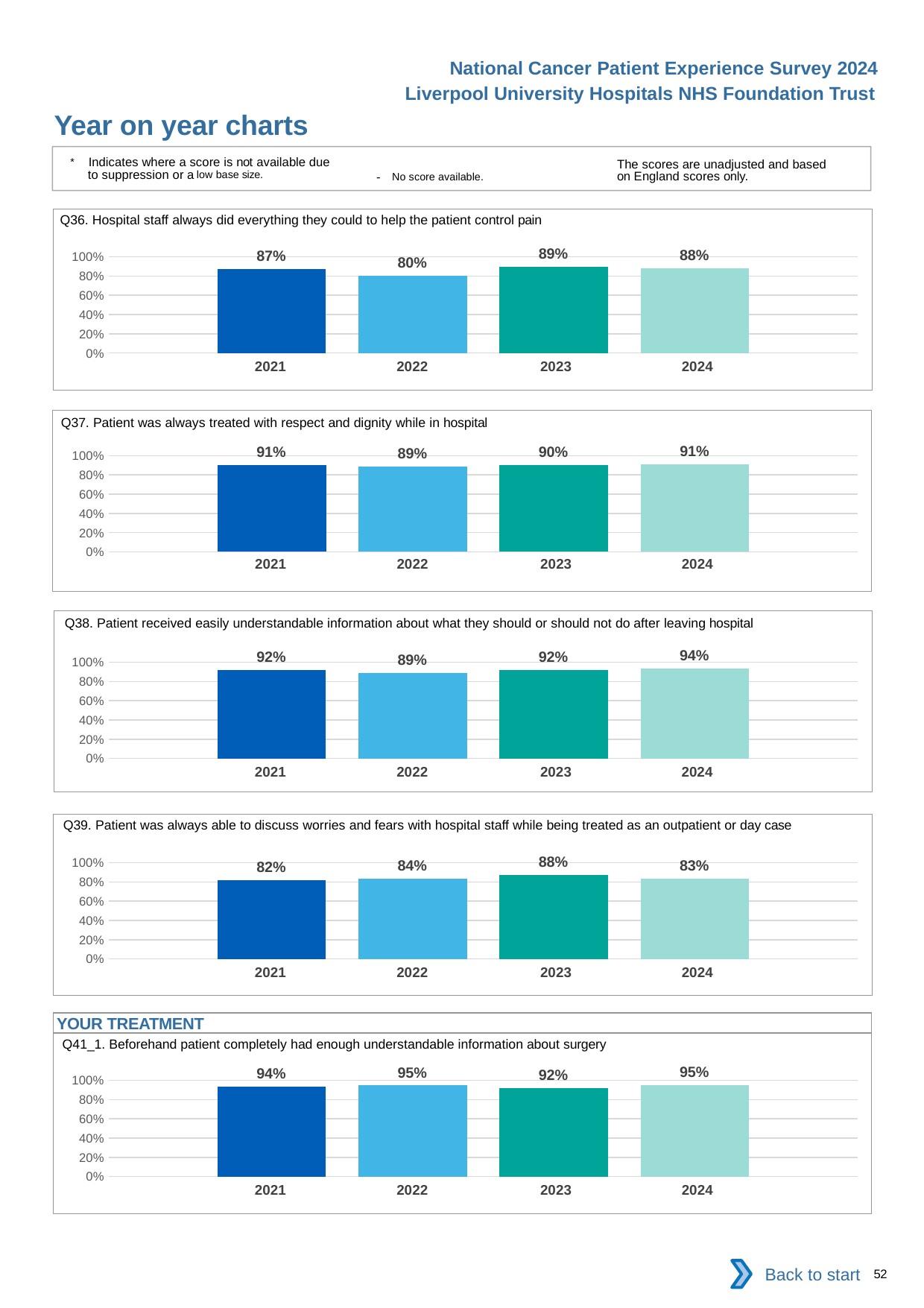
In the Q36 chart, which year has the highest value? 2023 In the Q41_1 chart, how many years are shown? 4 In the Q39 chart, what is the difference between the 2023 and 2021 values? 6% In the Q37 chart, what is the value for 2023? 90% In the Q37 chart, what is the difference between the 2021 and 2022 values? 2% In the Q38 chart, which year has the lowest value? 2022 In the Q41_1 chart, which year has the lowest value? 2023 In the Q38 chart, what is the value for 2024? 94% In the Q36 chart, what is the value for 2022? 80% In the Q39 chart, which is larger, the value for 2022 or the value for 2024? 2022 In the Q36 chart, is the value for 2021 greater or less than 80%? greater What kind of chart is the Q36 chart? bar chart